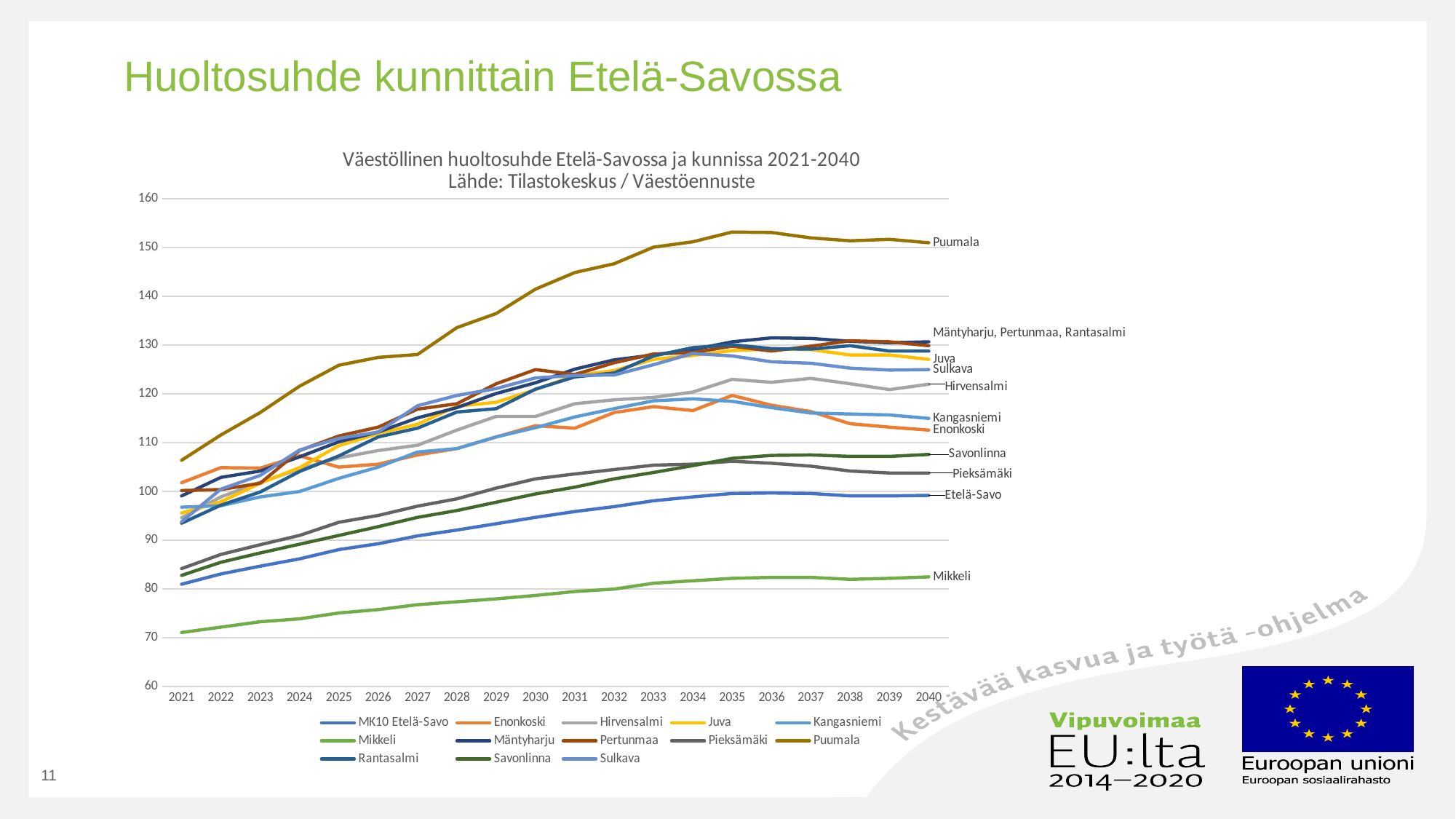
Does the value for Puumala rise or fall from 2021 to 2035? rise Does the value for Mikkeli rise or fall from 2021 to 2040? rise How many years are shown along the x axis? 20 Is the value for Mikkeli in 2040 greater or less than 90? less What kind of chart is shown on the slide? line chart Which municipality has the highest dependency ratio in 2040? Puumala Which municipality has the lowest dependency ratio in 2040? Mikkeli Is the value for Mikkeli in 2021 greater or less than 80? less In 2030, which is larger: the value for Puumala or the value for Mikkeli? Puumala Is the value for Puumala in 2040 greater or less than 140? greater What is the first line of the chart title? Väestöllinen huoltosuhde Etelä-Savossa ja kunnissa 2021-2040 How many series does the legend list? 13